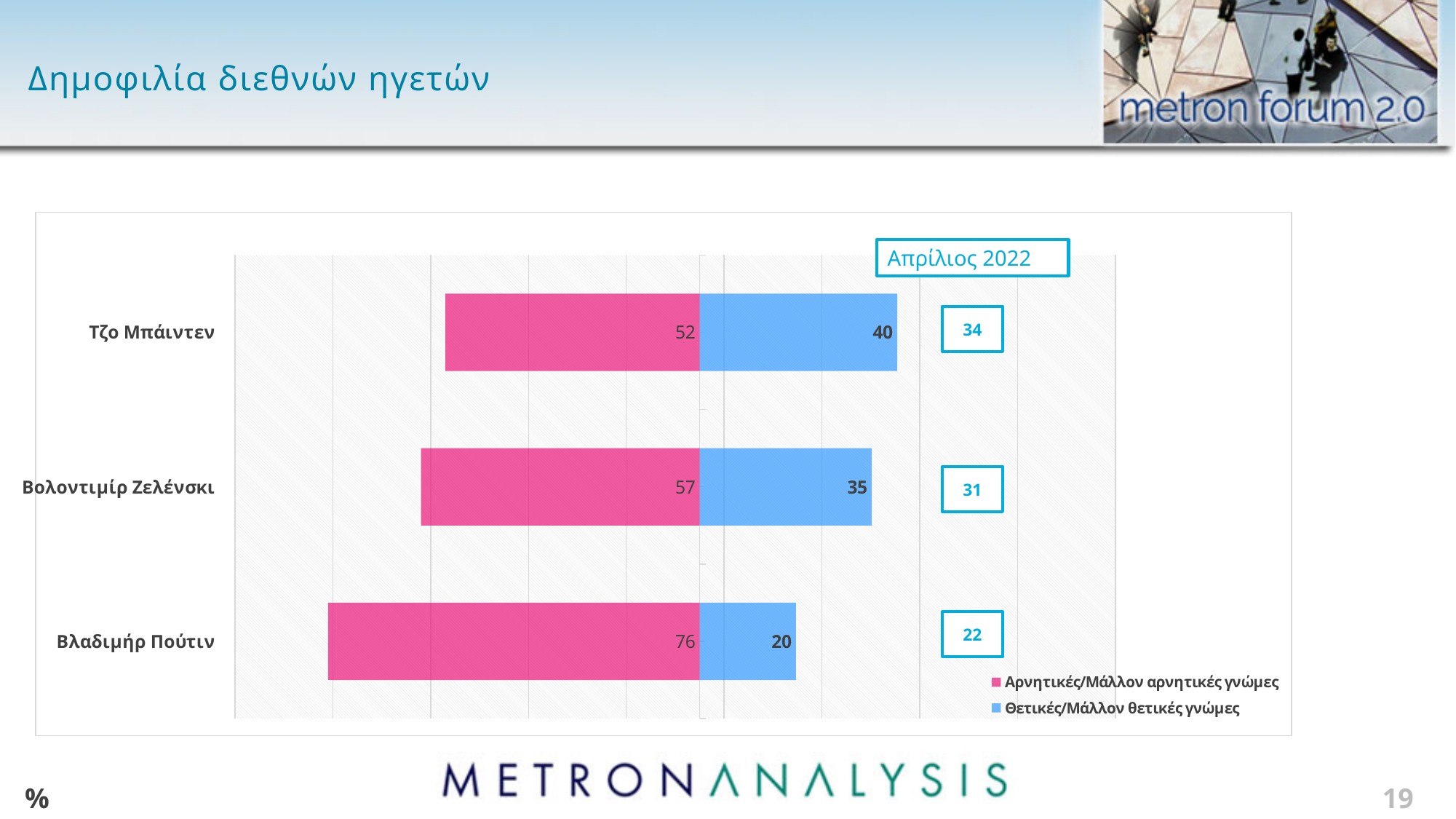
What is the value of Θετικές/Μάλλον θετικές γνώμες for Βολοντιμίρ Ζελένσκι? 35 Which leader has the highest value for Αρνητικές/Μάλλον αρνητικές γνώμες? Βλαδιμήρ Πούτιν What is the value of Θετικές/Μάλλον θετικές γνώμες for Τζο Μπάιντεν? 40 What kind of chart is shown on the slide? Bar chart How many leaders are shown in the chart? 3 How many series does the legend list? 2 What is the value of Αρνητικές/Μάλλον αρνητικές γνώμες for Βλαδιμήρ Πούτιν? 76 What is the difference between the Αρνητικές/Μάλλον αρνητικές γνώμες values for Βλαδιμήρ Πούτιν and Τζο Μπάιντεν? 24 Which is larger: the Θετικές/Μάλλον θετικές γνώμες value for Τζο Μπάιντεν or for Βολοντιμίρ Ζελένσκι? Τζο Μπάιντεν Which leader has the lowest value for Θετικές/Μάλλον θετικές γνώμες? Βλαδιμήρ Πούτιν What month and year is shown in the label on the chart? Απρίλιος 2022 What is the total of the two values shown for Βολοντιμίρ Ζελένσκι? 92